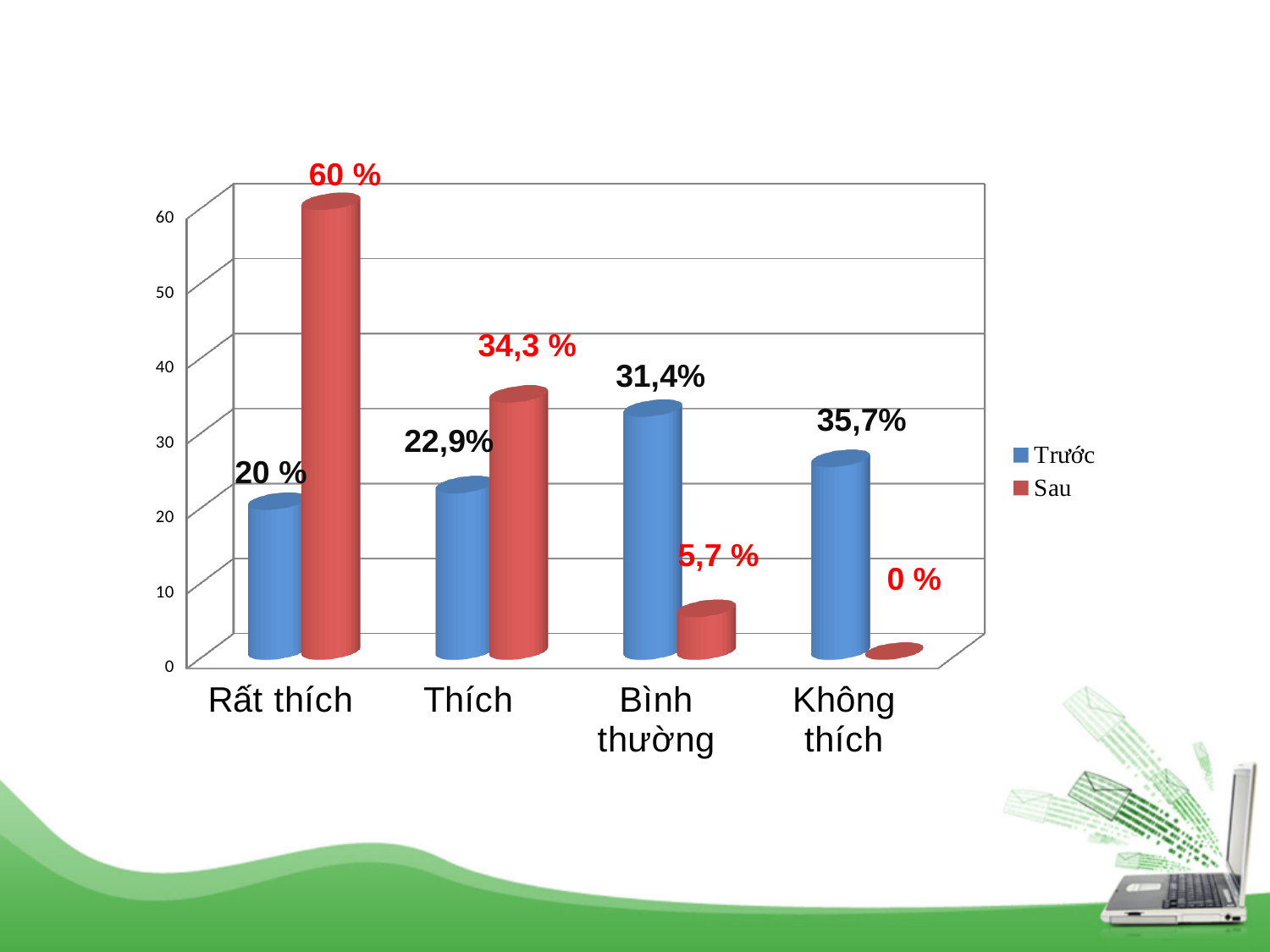
Which series is shown in red in the legend? Sau What is the value of the Trước series for Thích? 22,9% What is the value of the Sau series for Rất thích? 60 % Which category has the lowest value in the Trước series? Rất thích What is the value of the Sau series for Bình thường? 5,7 % What is the value of the Trước series for Không thích? 35,7% How many categories are shown on the x axis? 4 How many series does the legend list? 2 For Bình thường, which series has the larger value, Trước or Sau? Trước What is the difference between the Sau and Trước values for Rất thích? 40 % What type of chart is shown on the slide? Bar chart Which category has the highest value in the Sau series? Rất thích